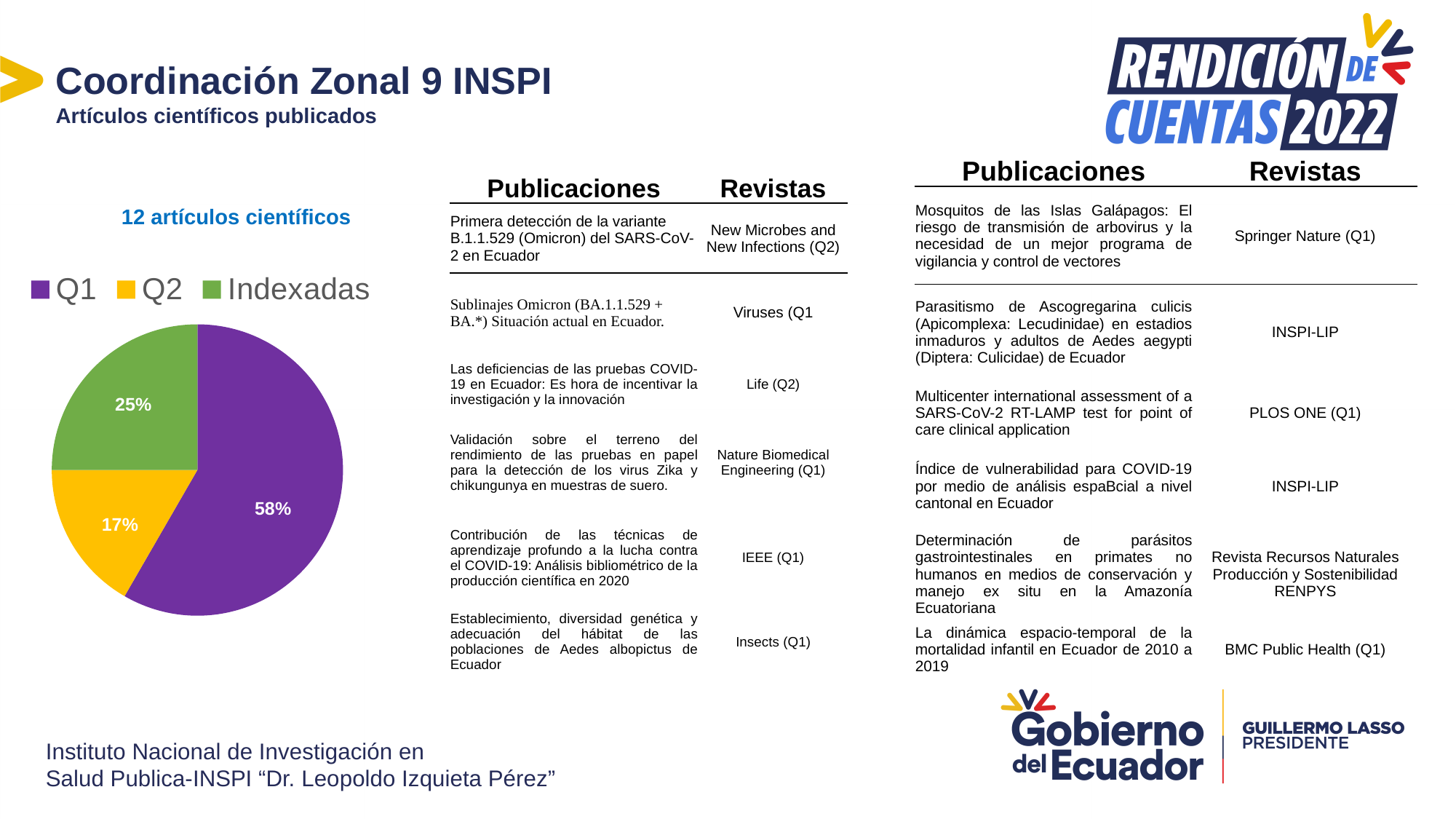
What kind of chart is shown on the slide? pie chart How many entries does the legend of the pie chart list? 3 What colour is the Q2 slice in the pie chart? yellow Which is larger, the Q2 slice or the Indexadas slice? Indexadas Which category has the smallest slice of the pie? Q2 What is the difference in percentage points between the Indexadas slice and the Q2 slice? 8 What share of the pie does Q1 represent? 58% Which category has the largest slice of the pie? Q1 How many slices does the pie chart have? 3 What share of the pie does Q2 represent? 17% What share of the pie does Indexadas represent? 25% What is the difference in percentage points between the Q1 slice and the Indexadas slice? 33